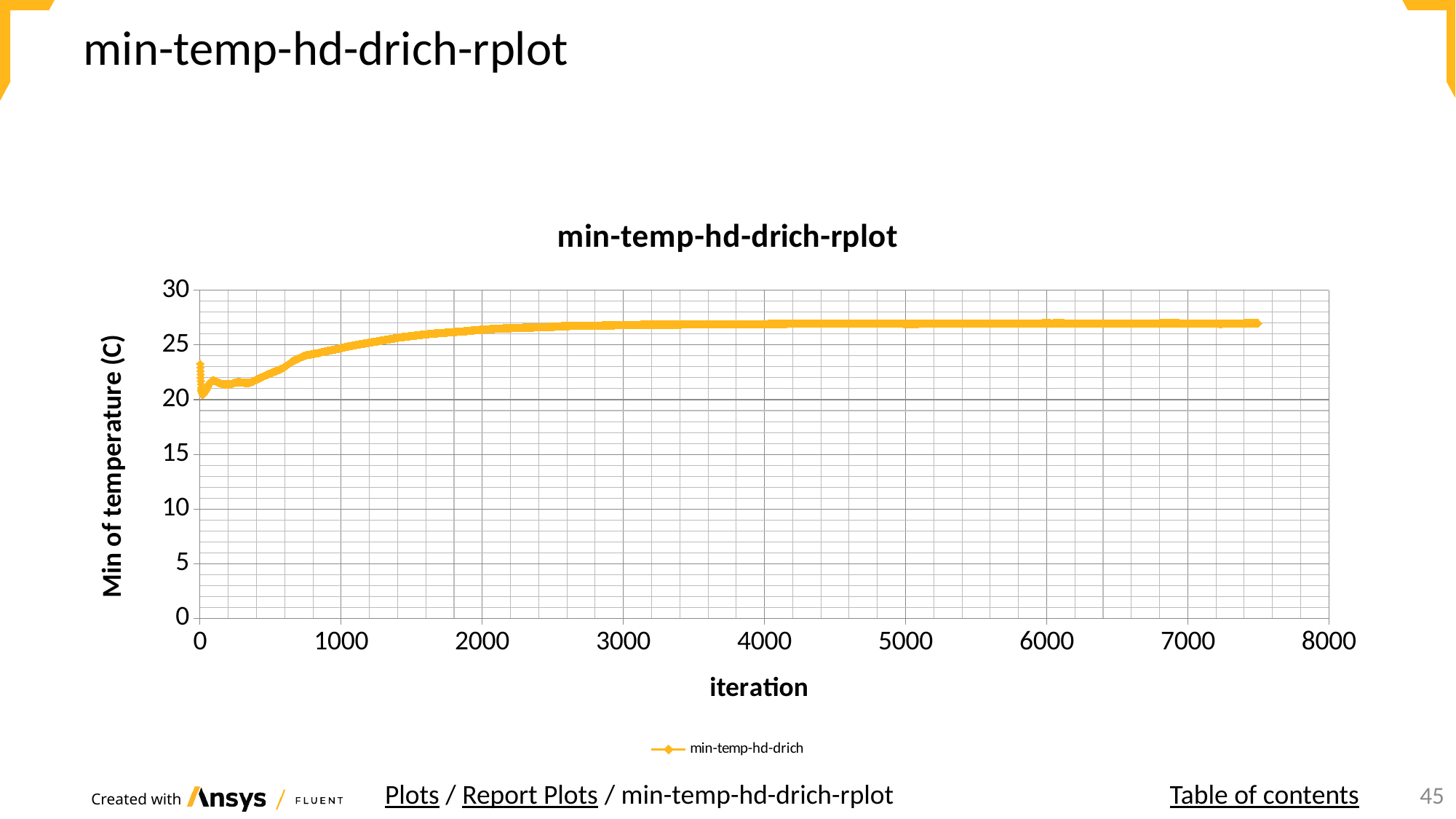
How many series does the legend list? 1 Does the min temperature generally rise or fall as the iteration count increases? rise What is the title of the chart? min-temp-hd-drich-rplot What kind of chart is shown on the slide? line chart Is the value for min-temp-hd-drich at iteration 6000 greater or less than 30? less Is the value for min-temp-hd-drich at iteration 7000 greater or less than 25? greater What is the name of the series shown in the legend? min-temp-hd-drich Is the value for min-temp-hd-drich at iteration 4000 greater or less than 25? greater Which is larger, the value for min-temp-hd-drich at iteration 300 or at iteration 3000? iteration 3000